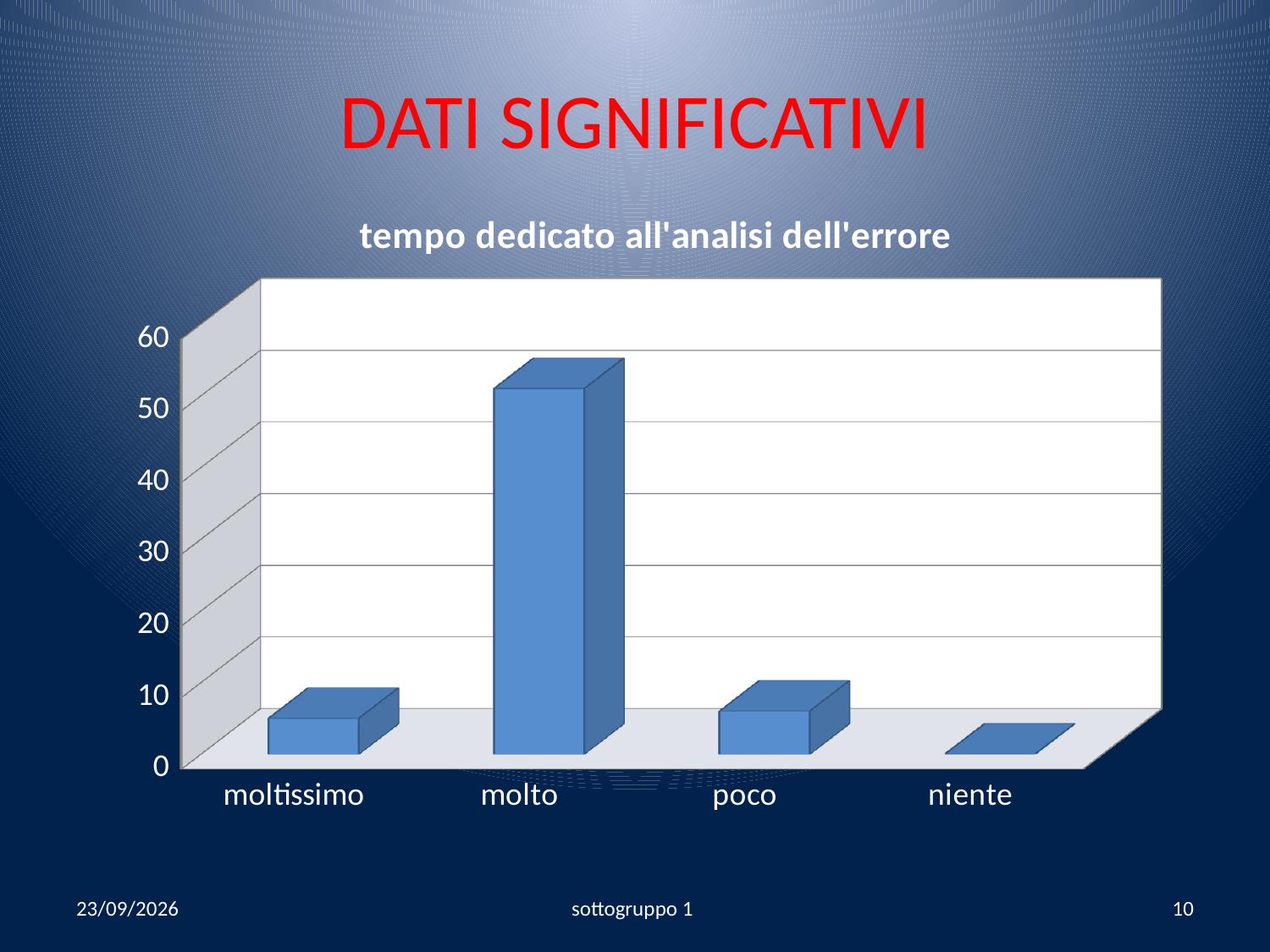
Which category has the highest value? molto Which category has the lowest value? niente Is the value for moltissimo greater or less than 10? less Is the value for molto greater or less than 40? greater What is the highest value shown on the vertical axis? 60 What is the title of the chart? tempo dedicato all'analisi dell'errore Is the value for niente greater or less than 10? less Which has the larger value, molto or poco? molto Which has the larger value, moltissimo or molto? molto What kind of chart is shown on the slide? bar chart How many categories are shown on the x axis of the chart? 4